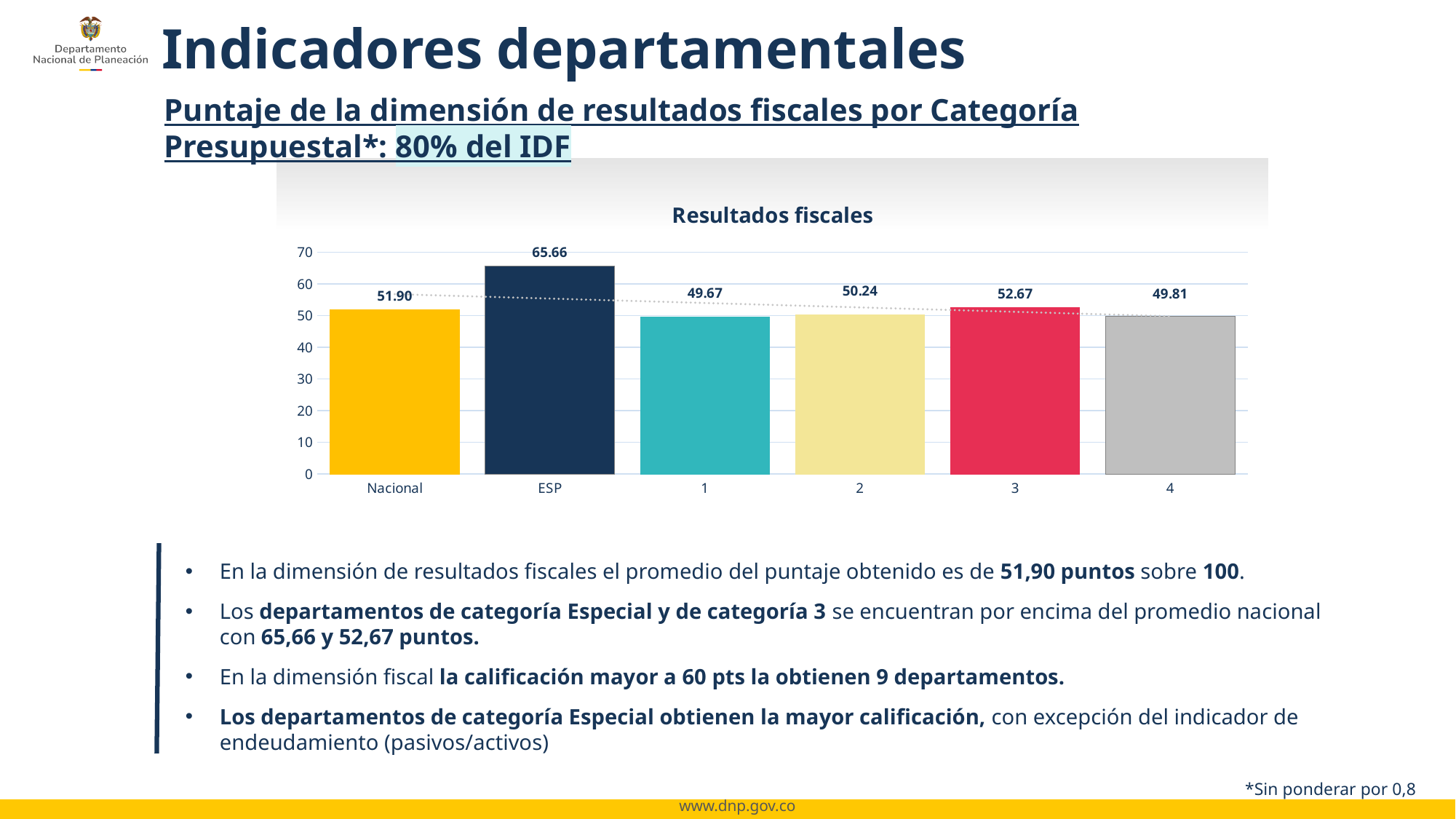
What is the value for category 3 in the Resultados fiscales chart? 52.67 Which category has the highest value in the Resultados fiscales chart? ESP What is the value for ESP in the Resultados fiscales chart? 65.66 How many categories are shown on the x axis of the Resultados fiscales chart? 6 What is the difference between the ESP value and the Nacional value in the Resultados fiscales chart? 13.76 What is the value for category 1 in the Resultados fiscales chart? 49.67 What is the title of the chart on the slide? Resultados fiscales What kind of chart is the Resultados fiscales chart? bar chart Is the value for ESP in the Resultados fiscales chart greater or less than 60? greater Which is larger in the Resultados fiscales chart, the value for category 2 or the value for category 3? 3 Which category has the lowest value in the Resultados fiscales chart? 1 What is the value for Nacional in the Resultados fiscales chart? 51.90